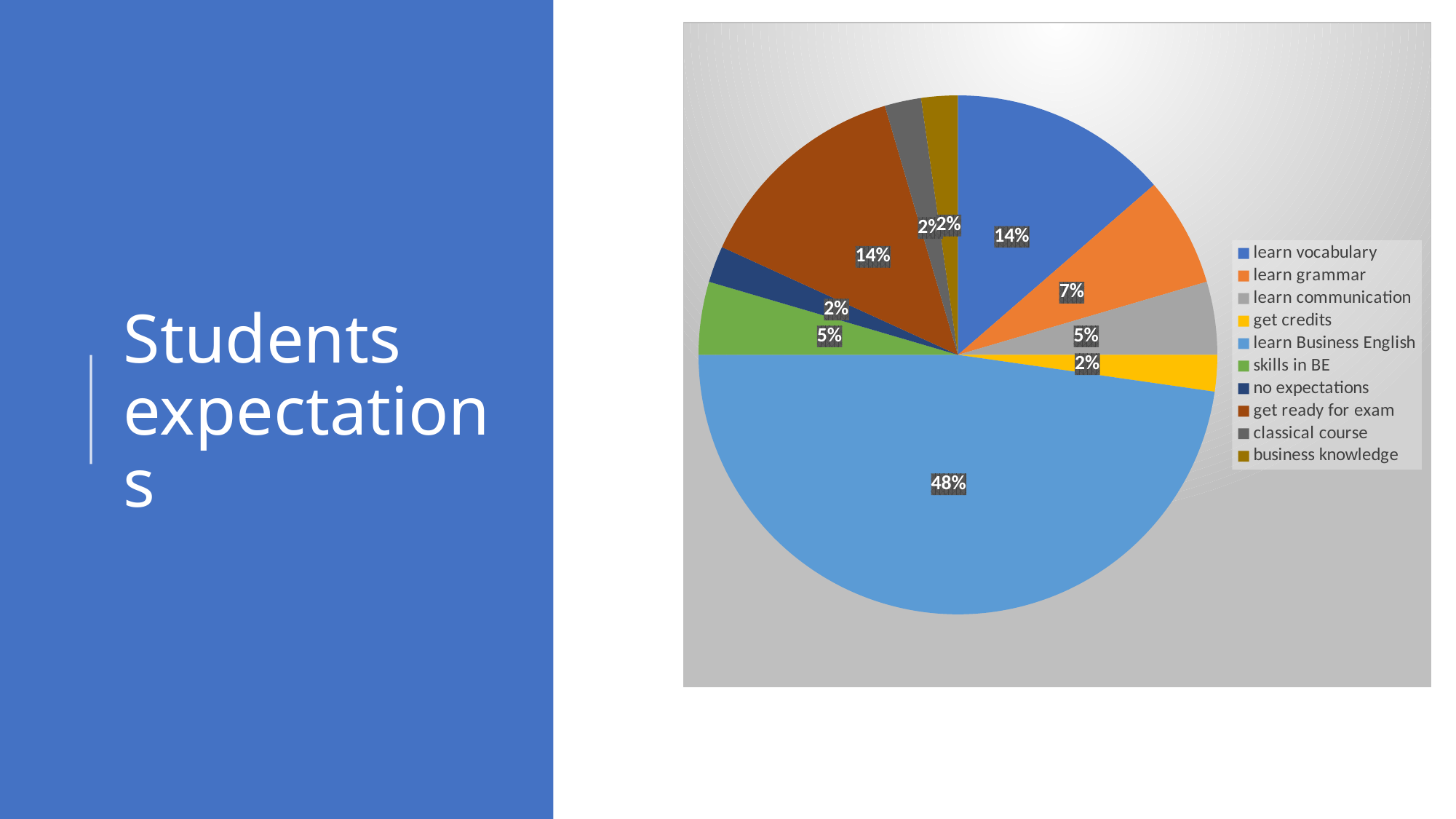
How many categories does the legend list? 10 What is the title of the slide containing the chart? Students expectations Which is larger, 'learn grammar' or 'learn communication'? learn grammar What is the value for 'learn grammar'? 7% What share of the pie does 'learn Business English' take? 48% What is the difference between 'learn Business English' and 'learn vocabulary'? 34 percentage points What is the value for 'learn vocabulary'? 14% What is the value for 'get credits'? 2% What kind of chart is shown on the slide? pie chart Which category has the largest slice of the pie? learn Business English What is the value for 'get ready for exam'? 14% What is the value for 'skills in BE'? 5%